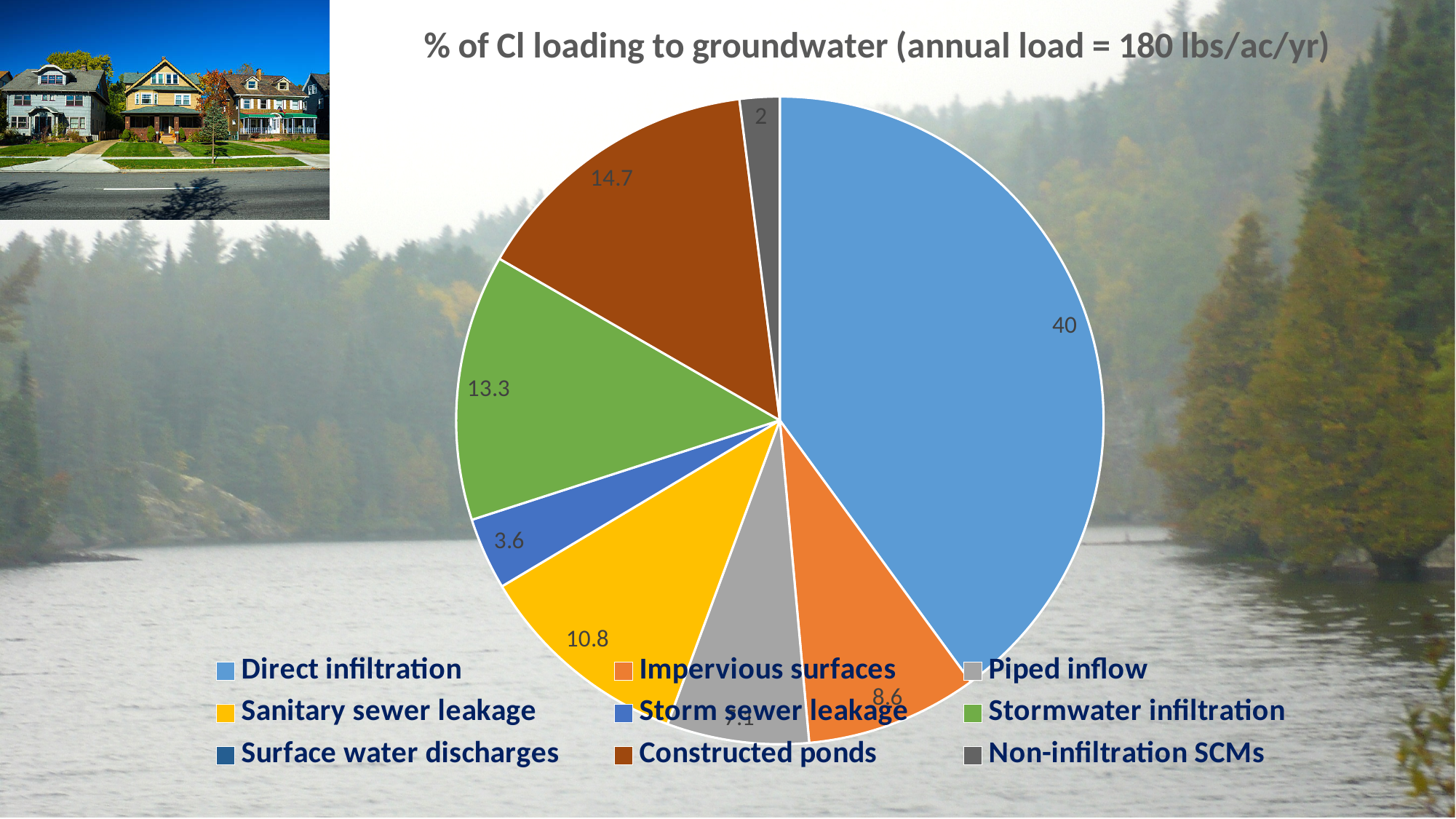
What is the difference between the Direct infiltration value and the Constructed ponds value? 25.3 What value is shown for Impervious surfaces? 8.6 What percentage of Cl loading to groundwater comes from Direct infiltration? 40 What value is shown for Sanitary sewer leakage? 10.8 What value is shown for Stormwater infiltration? 13.3 Which is larger, the share for Constructed ponds or for Stormwater infiltration? Constructed ponds What kind of chart is shown on the slide? pie chart Which category accounts for the largest share of Cl loading to groundwater? Direct infiltration What value is shown for Constructed ponds? 14.7 What value is shown for Non-infiltration SCMs? 2 What value is shown for Storm sewer leakage? 3.6 How many categories does the legend list? 9